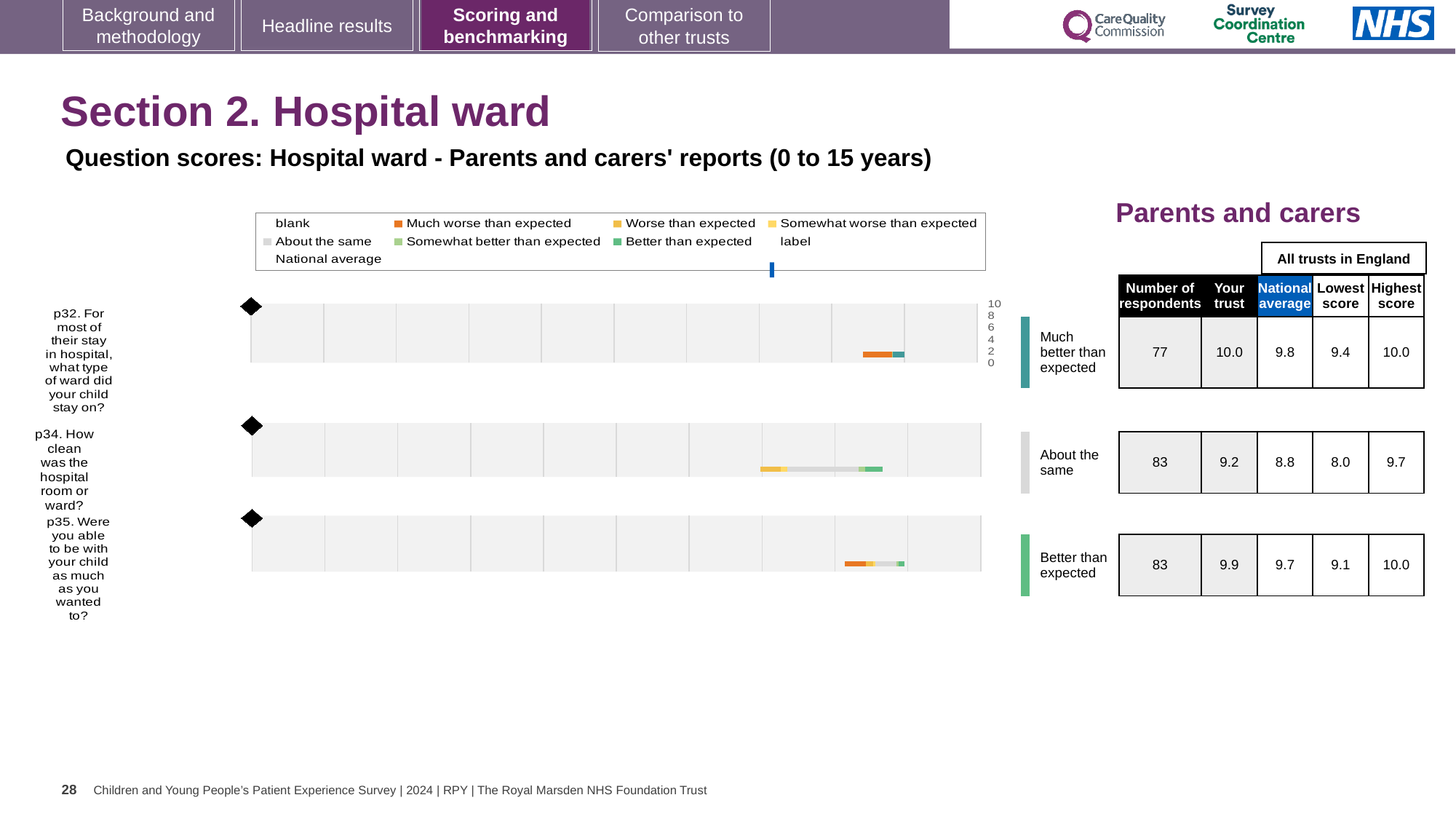
How many survey questions are plotted in the chart? 3 Which question has the highest 'Your trust' score? p32 According to the table, how many respondents answered p32 (what type of ward did your child stay on)? 77 For p34, which is larger: the 'Your trust' score or the national average? Your trust What is the lowest score among all trusts in England for p34? 8.0 What is the national average score for p35 (were you able to be with your child as much as you wanted to)? 9.7 What benchmark category is p32 assigned to? Much better than expected What is the difference between the 'Your trust' score and the national average for p34? 0.4 What kind of chart is shown on the slide? bar chart What is the highest score among all trusts in England for p32? 10.0 What is the 'Your trust' score for p34 (how clean was the hospital room or ward)? 9.2 Which question has the lowest 'Your trust' score? p34